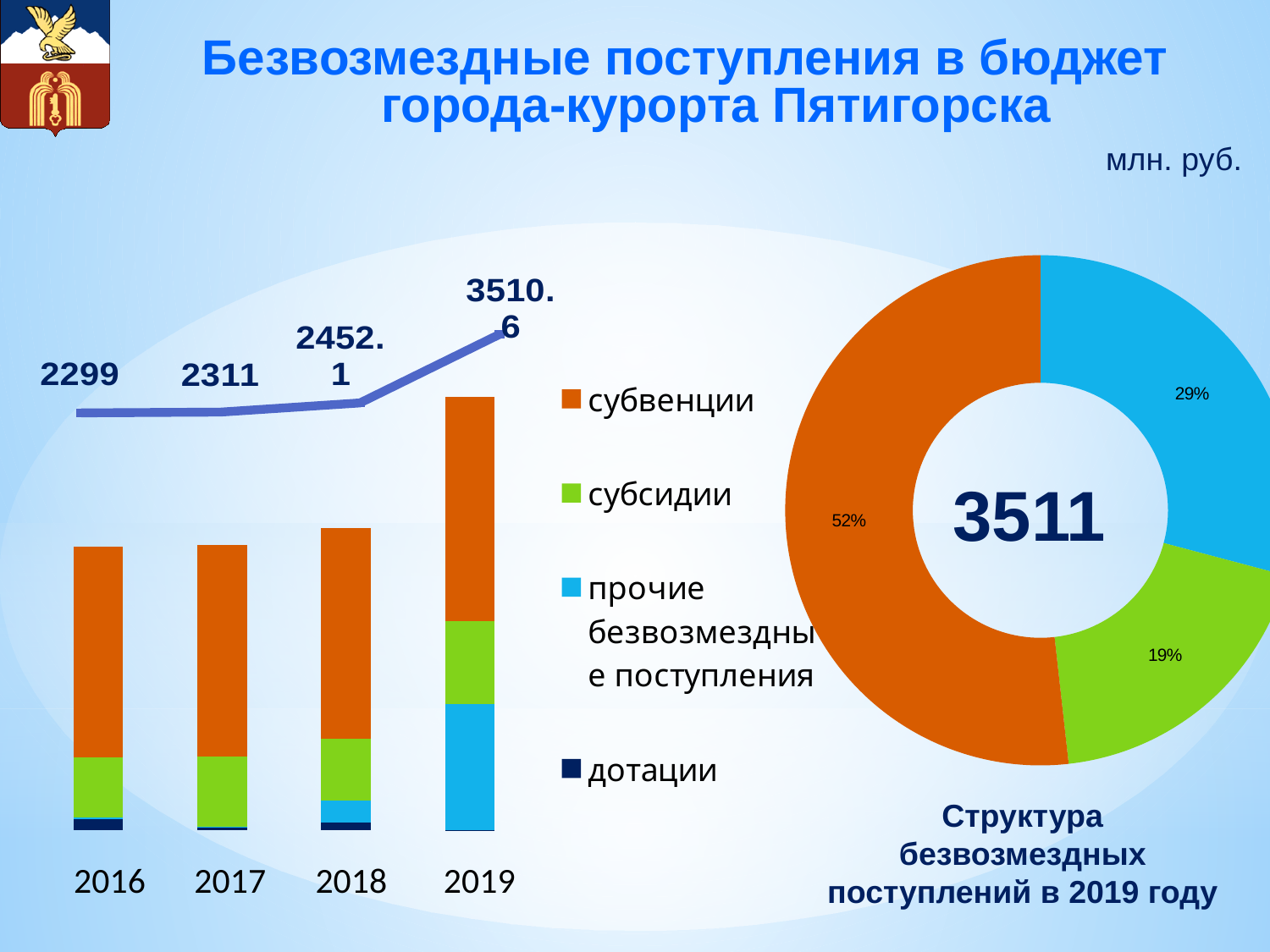
On the left chart, what is the total of gratuitous receipts (line label) for 2019? 3510.6 On the doughnut chart 'Структура безвозмездных поступлений в 2019 году', what share do субвенции (subventions) have? 52% On the left chart, how many series does the legend list? 4 On the doughnut chart 'Структура безвозмездных поступлений в 2019 году', what share do субсидии (subsidies) have? 19% On the left chart, which year has the lowest total of gratuitous receipts? 2016 On the left chart, how many years are shown on the x axis? 4 On the left chart, what is the difference between the 2019 total and the 2018 total? 1058.5 On the left chart, does the total of gratuitous receipts rise or fall from 2016 to 2019? rise On the left chart, which year has the highest total of gratuitous receipts? 2019 On the doughnut chart 'Структура безвозмездных поступлений в 2019 году', what total value is shown in the centre? 3511 On the left chart, what is the total of gratuitous receipts (line label) for 2016? 2299 On the left chart, what is the total of gratuitous receipts (line label) for 2018? 2452.1